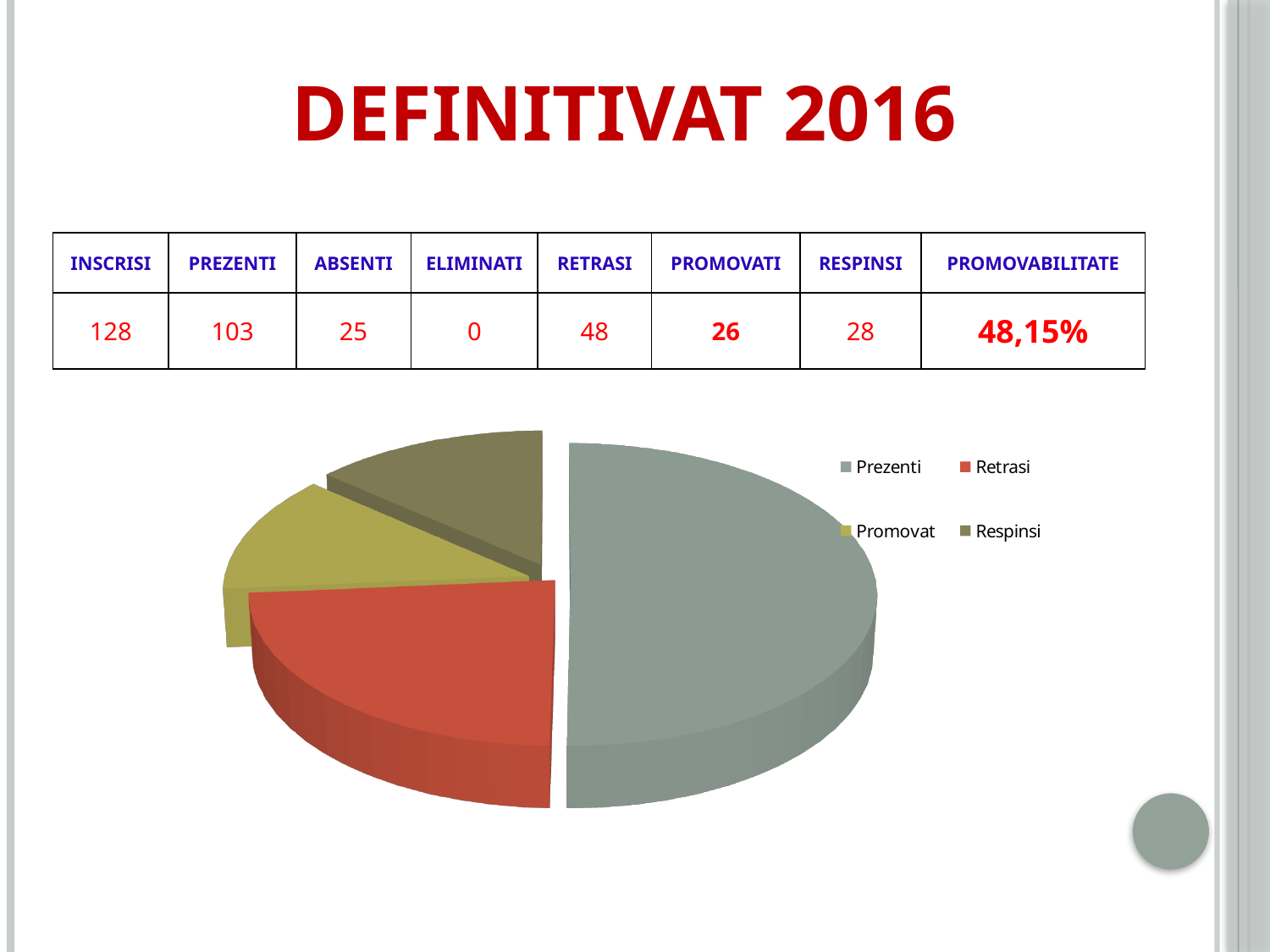
Which legend entry is shown in red in the pie chart? Retrasi What are the four legend entries of the pie chart? Prezenti, Retrasi, Promovat, Respinsi How many slices does the pie chart have? 4 How many entries does the pie chart's legend list? 4 Which slice is larger in the pie chart, Prezenti or Retrasi? Prezenti Which slice is larger in the pie chart, Retrasi or Promovat? Retrasi Which category has the largest slice in the pie chart? Prezenti What kind of chart is shown on the slide? pie chart Which slice is larger in the pie chart, Retrasi or Respinsi? Retrasi